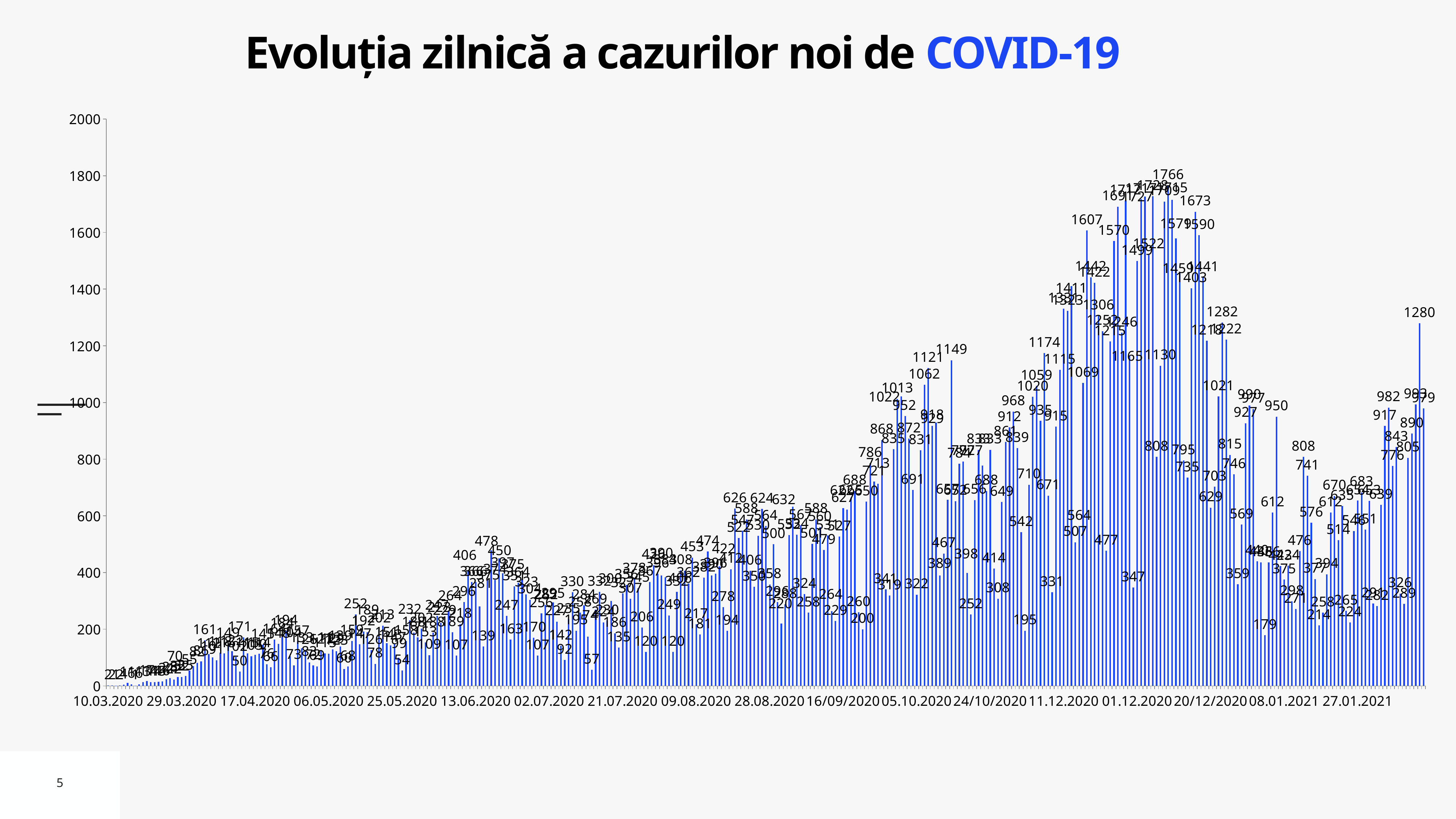
What is the first date label on the horizontal axis? 10.03.2020 What is the difference between the peak value (1766) and the rightmost bar value (1280)? 486 What is the value of the last (rightmost) bar on the chart? 1280 What kind of chart is shown on the slide? bar chart What is the value of the local peak labeled near 13.06.2020? 478 Which is larger: the peak value of 1766 or the rightmost bar value of 1280? 1766 Do the daily values generally rise or fall from 10.03.2020 to 01.12.2020? rise Is the value of the first bar (10.03.2020) greater or less than 200? less What is the maximum value shown on the vertical axis? 2000 Is the peak bar in December 2020 greater or less than 1600? greater What is the title of the chart? Evoluția zilnică a cazurilor noi de COVID-19 What is the highest daily value labeled on the chart? 1766